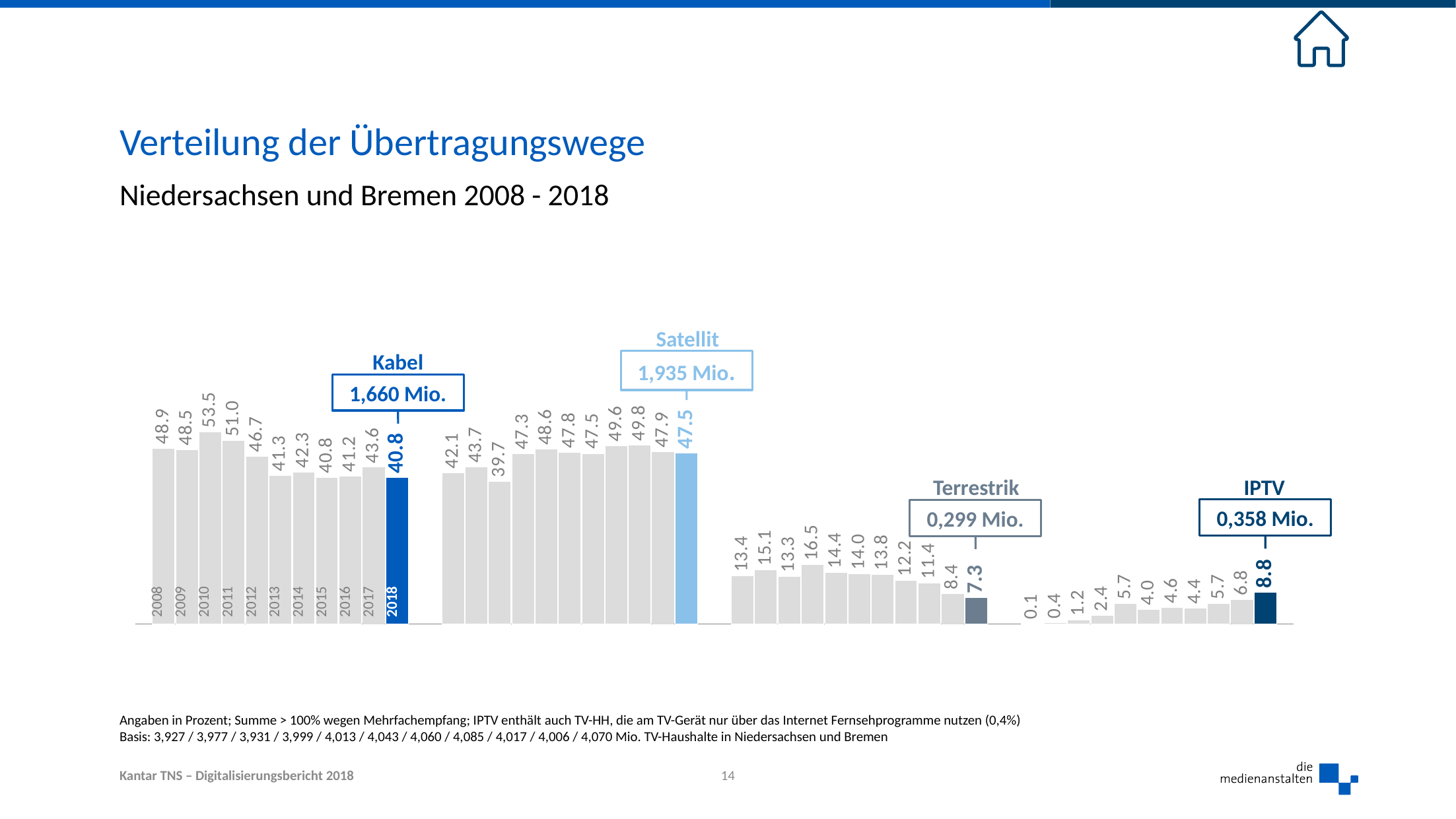
How many bars are shown in the Kabel group? 11 What number of households (in Mio.) is shown in the callout box for Satellit? 1,935 Mio. What is the difference between the Kabel value in 2008 and in 2018? 8.1 What is the lowest value shown in the Satellit group? 39.7 What is the Kabel value for 2018? 40.8 What is the highlighted 2018 value for IPTV? 8.8 What is the highlighted 2018 value for Terrestrik? 7.3 What kind of chart is shown on the slide? Bar chart What is the highlighted 2018 value for Satellit? 47.5 In which year was the Kabel value highest? 2010 Do the IPTV values generally rise or fall from the first bar to the last bar? Rise Which is larger in 2018, the Kabel value or the Satellit value? Satellit